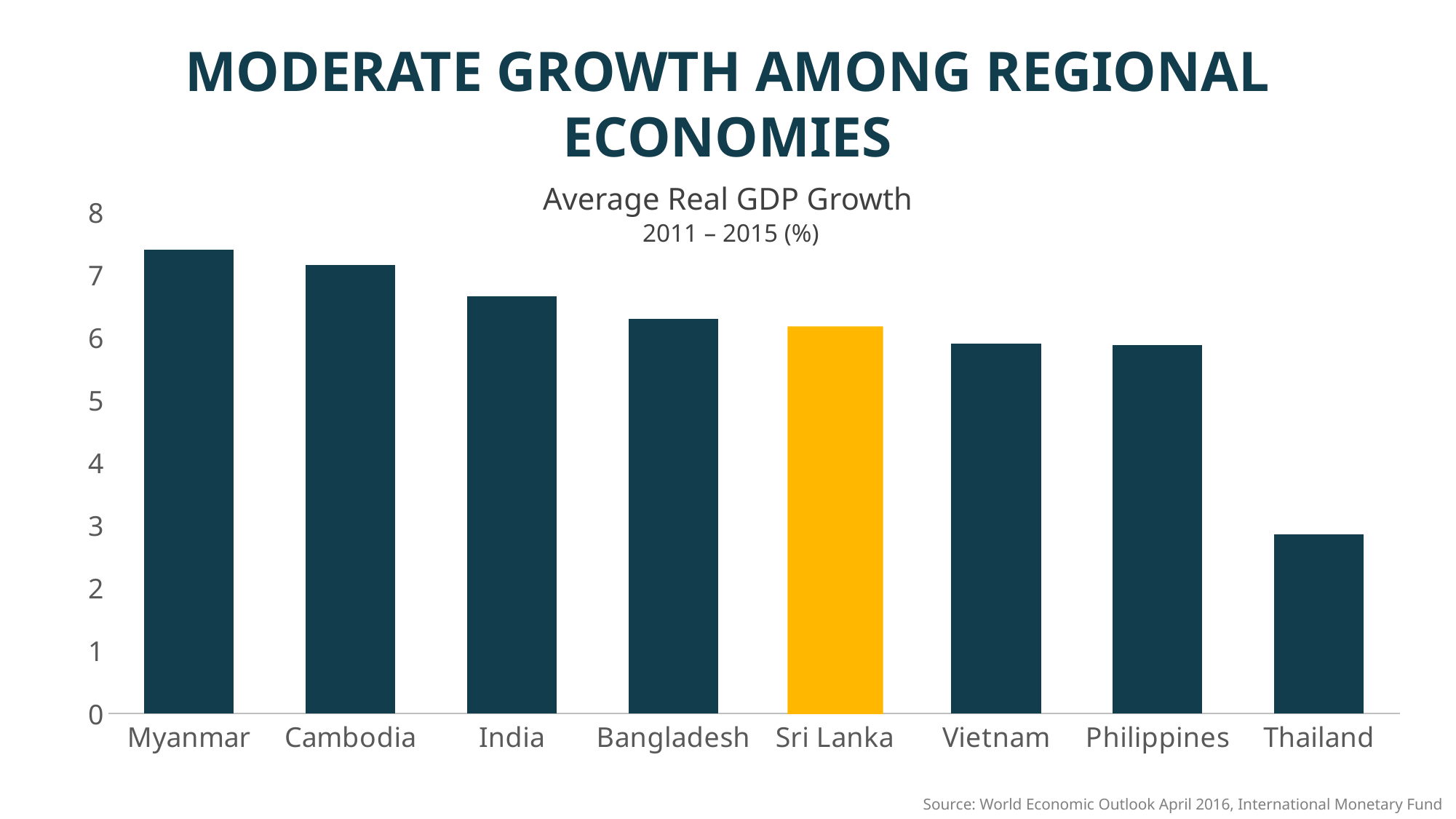
What kind of chart is shown on the slide? bar chart Is the value for Thailand greater or less than 3? less Do the values rise or fall from left to right across the chart? fall Is the value for Myanmar greater or less than 7? greater What is the chart's title? Average Real GDP Growth 2011 – 2015 (%) Which country's bar is highlighted in a different colour (yellow)? Sri Lanka Which country has the lowest average real GDP growth? Thailand Which country has the highest average real GDP growth? Myanmar How many countries are shown on the chart? 8 Which has the larger value, Cambodia or India? Cambodia